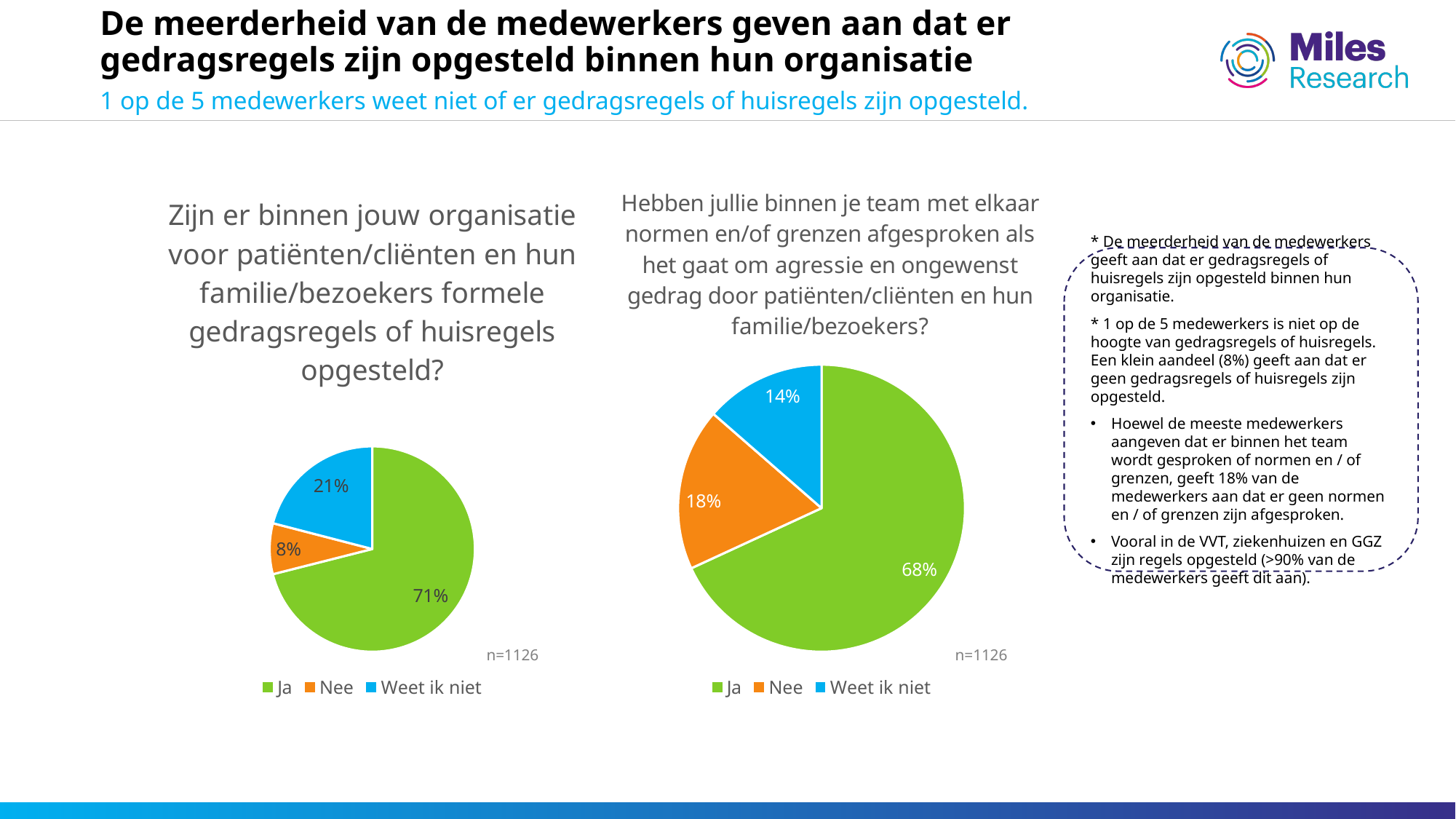
In the right pie chart, what share is labelled for 'Nee'? 18% How many categories does the legend of the left pie chart list? 3 Which is larger: the 'Nee' share in the left pie chart or the 'Nee' share in the right pie chart? The right pie chart (18%) What type of chart is used on this slide? Pie chart In the right pie chart (Hebben jullie binnen je team ... normen en/of grenzen afgesproken ...?), what share is labelled for 'Ja'? 68% In the left pie chart (Zijn er binnen jouw organisatie ... gedragsregels of huisregels opgesteld?), what share is labelled for 'Ja'? 71% In the right pie chart, which category has the largest slice? Ja In the right pie chart, what share is labelled for 'Weet ik niet'? 14% What is the difference between the 'Ja' share in the left pie chart and the 'Ja' share in the right pie chart? 3 percentage points In the left pie chart, what share is labelled for 'Nee'? 8% In the left pie chart, which category has the smallest slice? Nee In the left pie chart, what share is labelled for 'Weet ik niet'? 21%